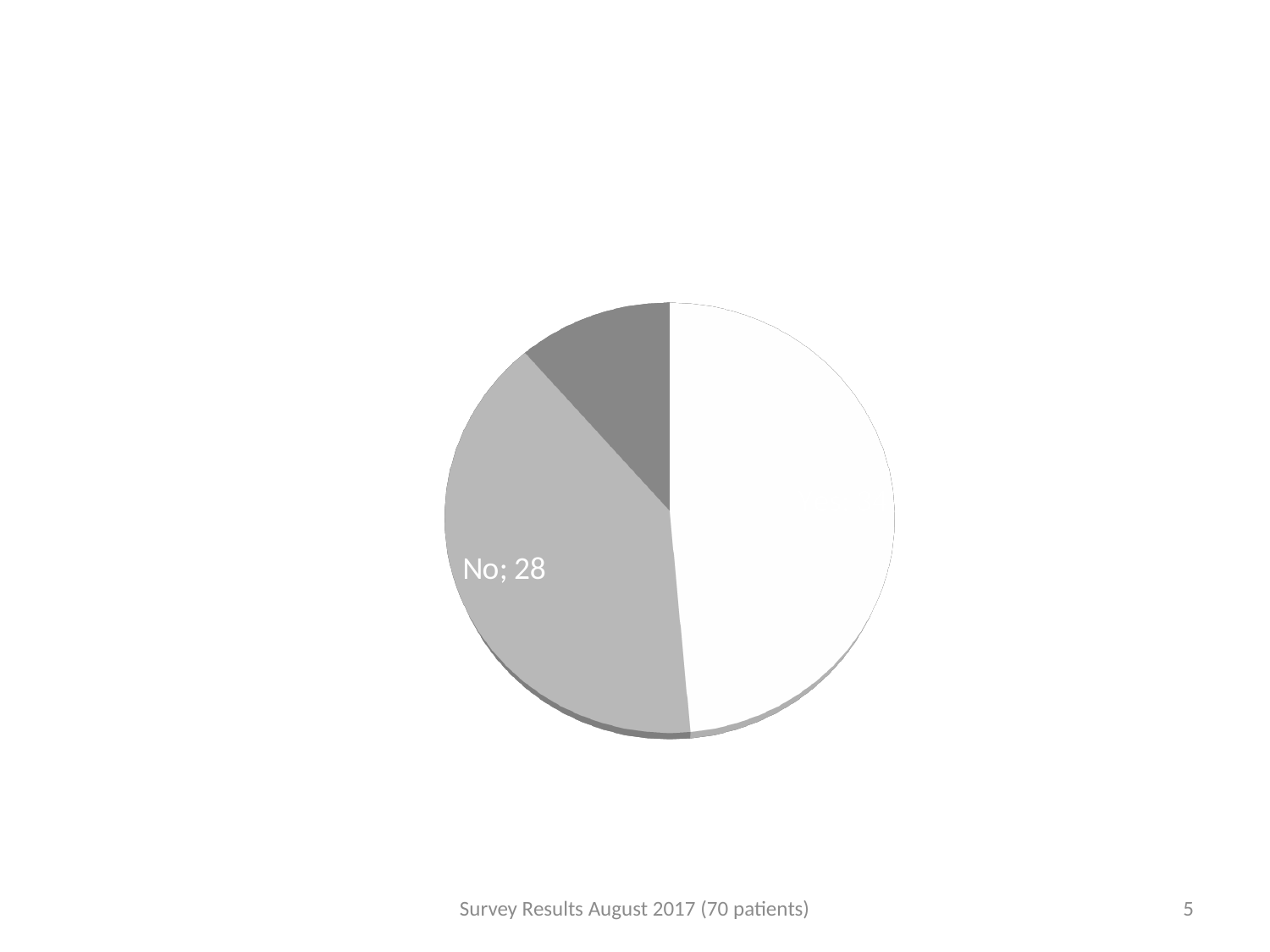
Is the white slice of the pie chart larger or smaller than the "No" slice? larger Which slice of the pie chart has a printed data label? No What colour is the "No" slice of the pie chart? light grey Is the dark grey slice of the pie chart larger or smaller than the "No" slice? smaller What kind of chart is shown on the slide? pie chart What value is shown for the "No" slice of the pie chart? 28 How many slices does the pie chart have? 3